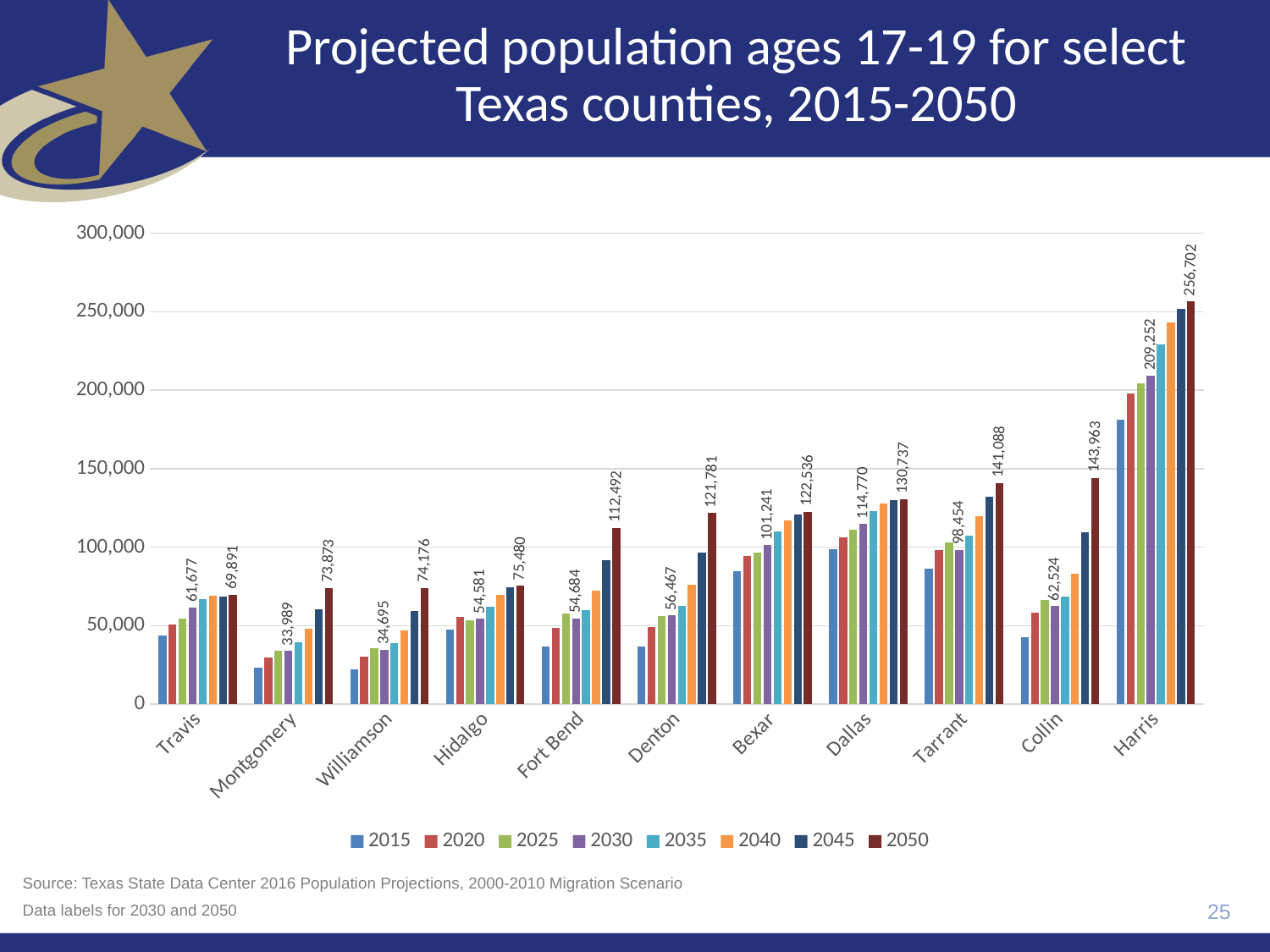
What kind of chart is shown on the slide? Bar chart Is the 2015 value for Harris County greater or less than 150,000? greater What is the difference between the 2050 and 2030 projected values for Collin County? 81,439 For which two years are data labels shown on the chart? 2030 and 2050 How many counties are shown on the x axis? 11 What is the projected 2030 population ages 17-19 for Tarrant County? 98,454 Which is larger, the 2050 value for Denton or the 2050 value for Fort Bend? Denton What is the projected 2030 value for Montgomery County? 33,989 Which county has the highest projected 2050 population ages 17-19? Harris What is the projected 2050 population ages 17-19 for Harris County? 256,702 Which county has the lowest projected 2030 population ages 17-19? Montgomery How many series does the legend list? 8